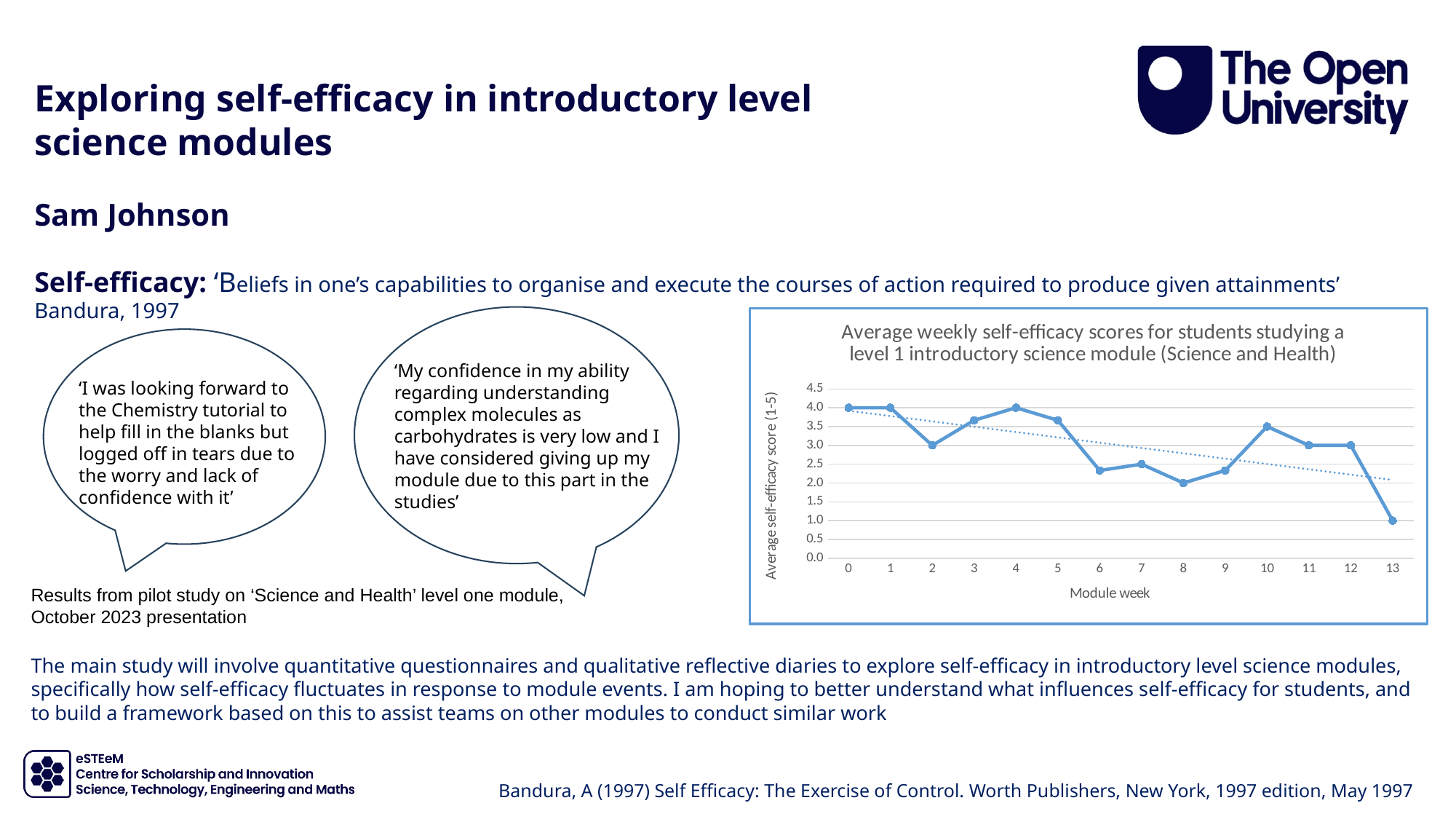
Is the average self-efficacy score at module week 3 greater or less than 3.5? greater What is the average self-efficacy score at module week 13? 1.0 What is the label of the x axis of the chart? Module week What is the average self-efficacy score at module week 10? 3.5 What is the average self-efficacy score at module week 8? 2.0 Is the average self-efficacy score at module week 6 greater or less than 2.5? less Overall, do the average self-efficacy scores rise or fall from week 0 to week 13? Fall What is the title of the chart? Average weekly self-efficacy scores for students studying a level 1 introductory science module (Science and Health) How many module weeks are plotted on the chart? 14 Which module week has the lowest average self-efficacy score? 13 Which has the higher average self-efficacy score, module week 10 or module week 8? Module week 10 What kind of chart is shown on the slide? Line chart